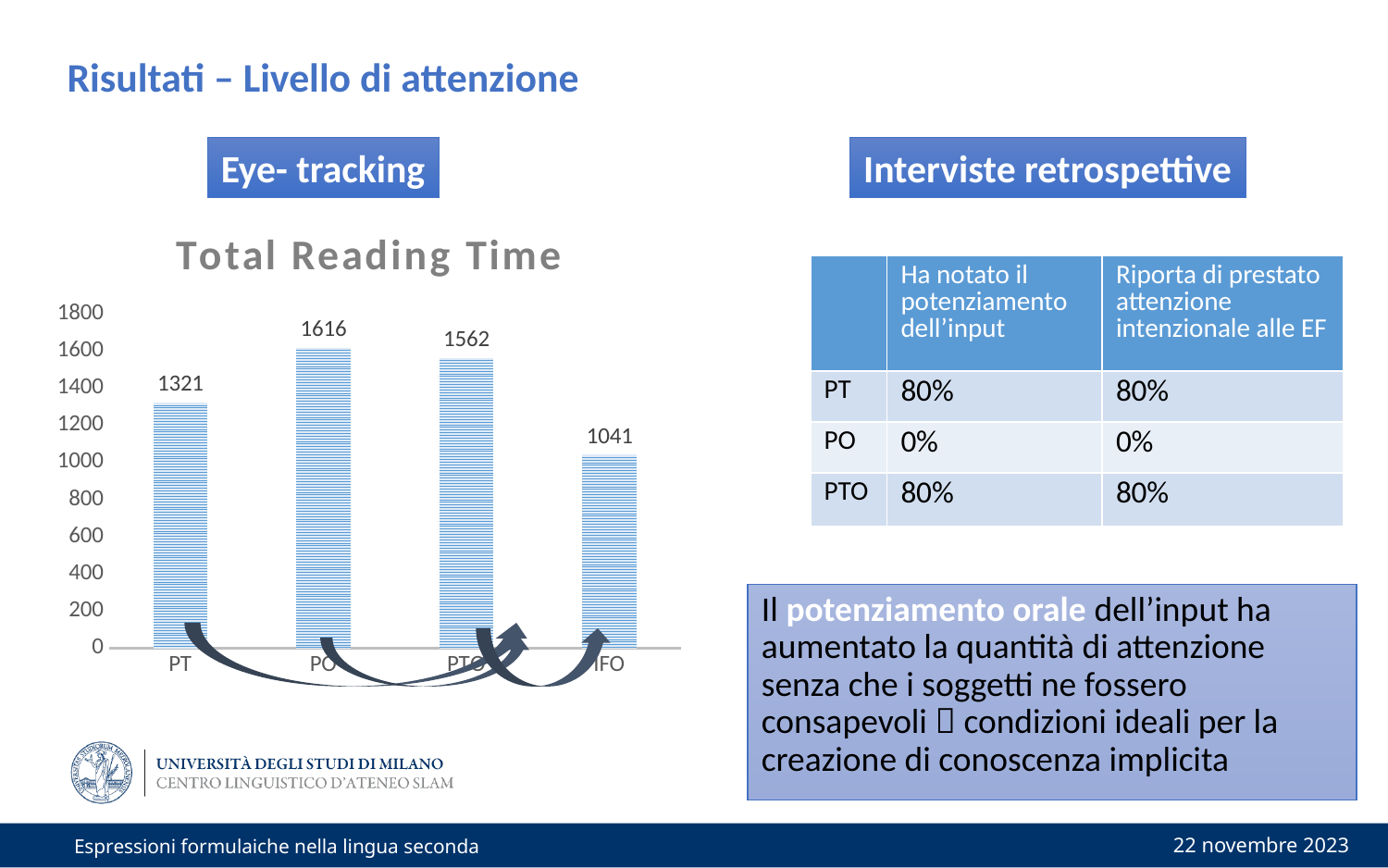
What is the title of the chart on the left side of the slide? Total Reading Time In the Total Reading Time chart, what is the value for PT? 1321 In the Total Reading Time chart, which category has the highest value? PO In the Total Reading Time chart, what is the value for PTO? 1562 In the Total Reading Time chart, what is the value for PO? 1616 In the Total Reading Time chart, what is the lowest value shown? 1041 In the Total Reading Time chart, what is the value of the rightmost bar? 1041 In the Total Reading Time chart, what is the difference between the values for PO and PT? 295 How many bars are shown in the Total Reading Time chart? 4 In the Total Reading Time chart, what is the difference between the values for PO and PTO? 54 What kind of chart is the Total Reading Time chart? bar chart In the Total Reading Time chart, which is larger, the value for PT or the value for PTO? PTO